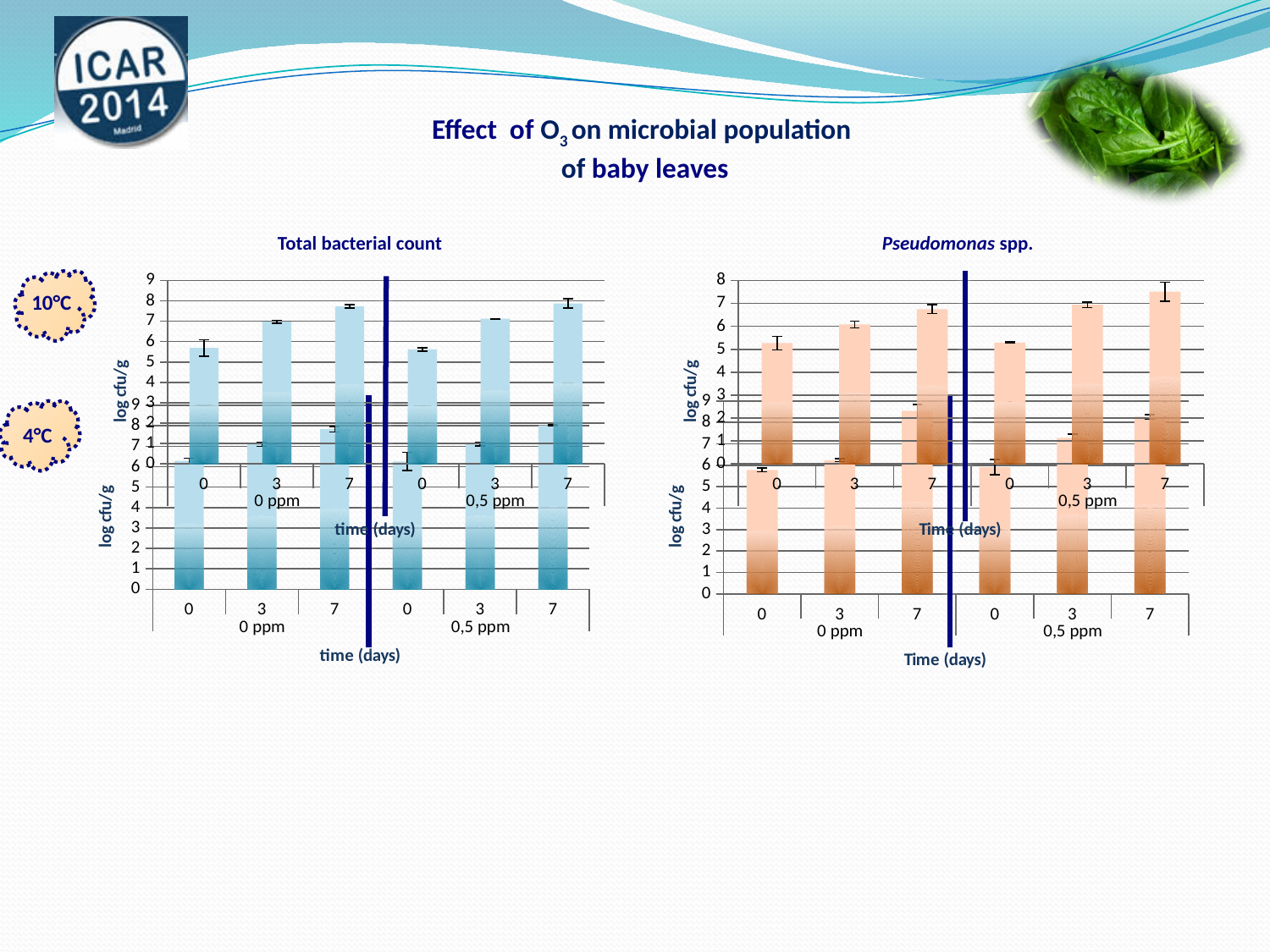
In the Pseudomonas spp. chart at 10°C, which bar is the highest? day 7 at 0,5 ppm What are the two ozone concentrations shown on the x axis of the Pseudomonas spp. charts? 0 ppm and 0,5 ppm In the Total bacterial count chart at 10°C, do the values at 0 ppm rise or fall from day 0 to day 7? rise In the Total bacterial count chart at 10°C, is the value for day 7 at 0,5 ppm greater or less than 7? greater In the Total bacterial count chart at 10°C, how many bars are plotted? 6 What is the y-axis label on the Total bacterial count charts? log cfu/g In the Pseudomonas spp. chart at 10°C, which is larger for day 3: the value at 0 ppm or the value at 0,5 ppm? 0,5 ppm In the Pseudomonas spp. chart at 10°C, is the value for day 0 at 0 ppm greater or less than 6? less In the Total bacterial count chart at 10°C, which is larger at 0 ppm: the value for day 0 or the value for day 7? day 7 What kind of chart is used for the Total bacterial count at 10°C? bar chart In the Pseudomonas spp. chart at 10°C, is the value for day 7 at 0 ppm greater or less than 6? greater